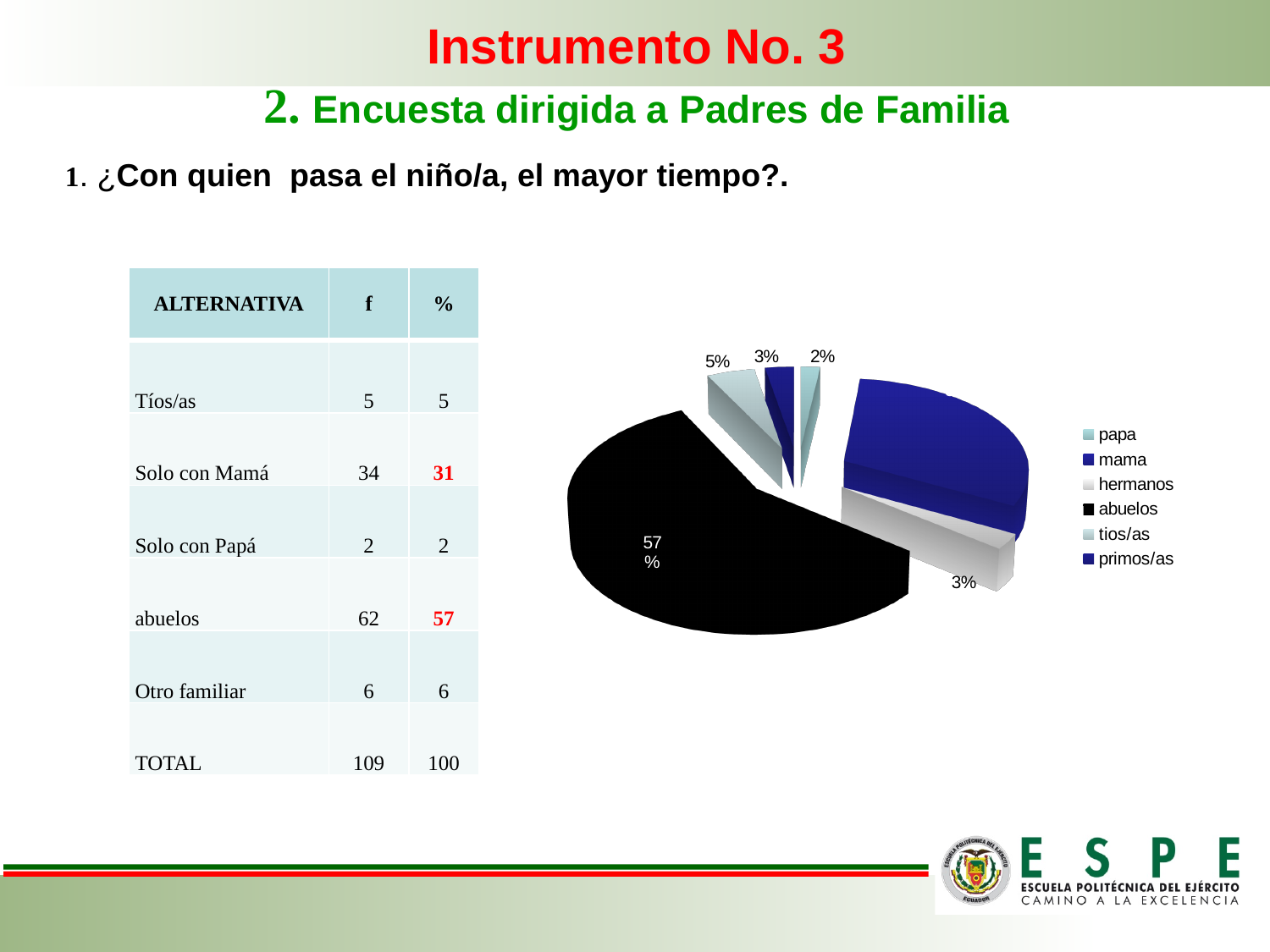
How many percentage labels are printed on the pie chart? 5 How many entries does the legend of the pie chart list? 6 What is the smallest percentage label printed on the pie chart? 2% Which slice is larger in the pie chart, abuelos or mama? abuelos Is the abuelos slice of the pie chart greater or less than 50% of the pie? greater Which category has the largest slice in the pie chart? abuelos What percentage is shown on the abuelos slice of the pie chart? 57% Which legend entry is listed first in the pie chart's legend? papa What kind of chart is shown on the slide? pie chart Is the mama slice of the pie chart greater or less than 50% of the pie? less What colour is used for the abuelos slice in the pie chart? black